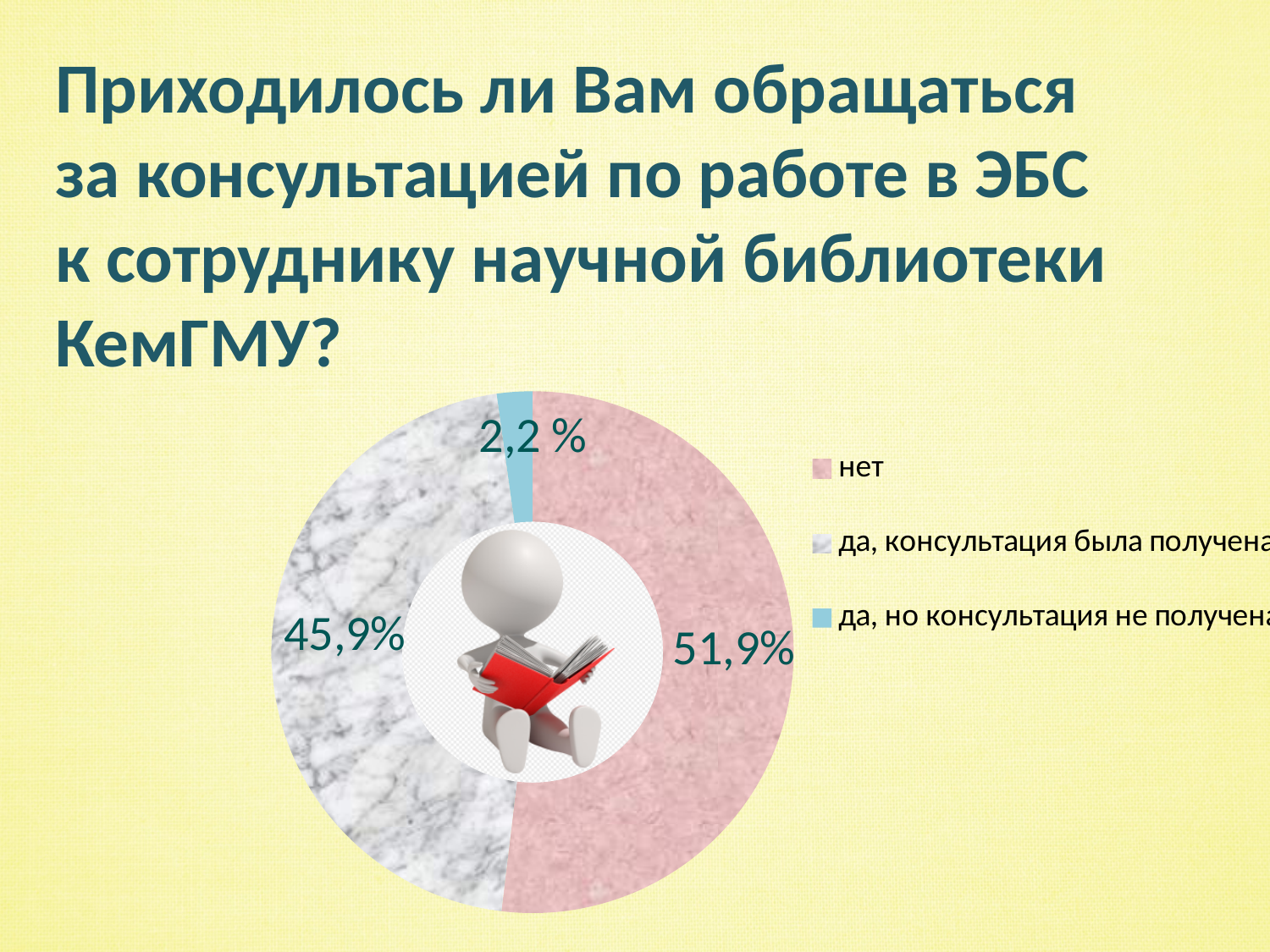
Which answer has the largest share of the pie? нет Which legend entry is shown in light blue? да, но консультация не получена What share of respondents answered "нет"? 51,9% What share of respondents answered "да, но консультация не получена"? 2,2 % What share of respondents answered "да, консультация была получена"? 45,9% What is the difference in percentage points between "да, консультация была получена" and "да, но консультация не получена"? 43,7% Which is larger: the share for "нет" or the share for "да, консультация была получена"? нет How many entries does the legend list? 3 What is the difference in percentage points between "нет" and "да, консультация была получена"? 6% How many slices does the pie chart have? 3 Which answer has the smallest share of the pie? да, но консультация не получена What kind of chart is shown on the slide? doughnut chart